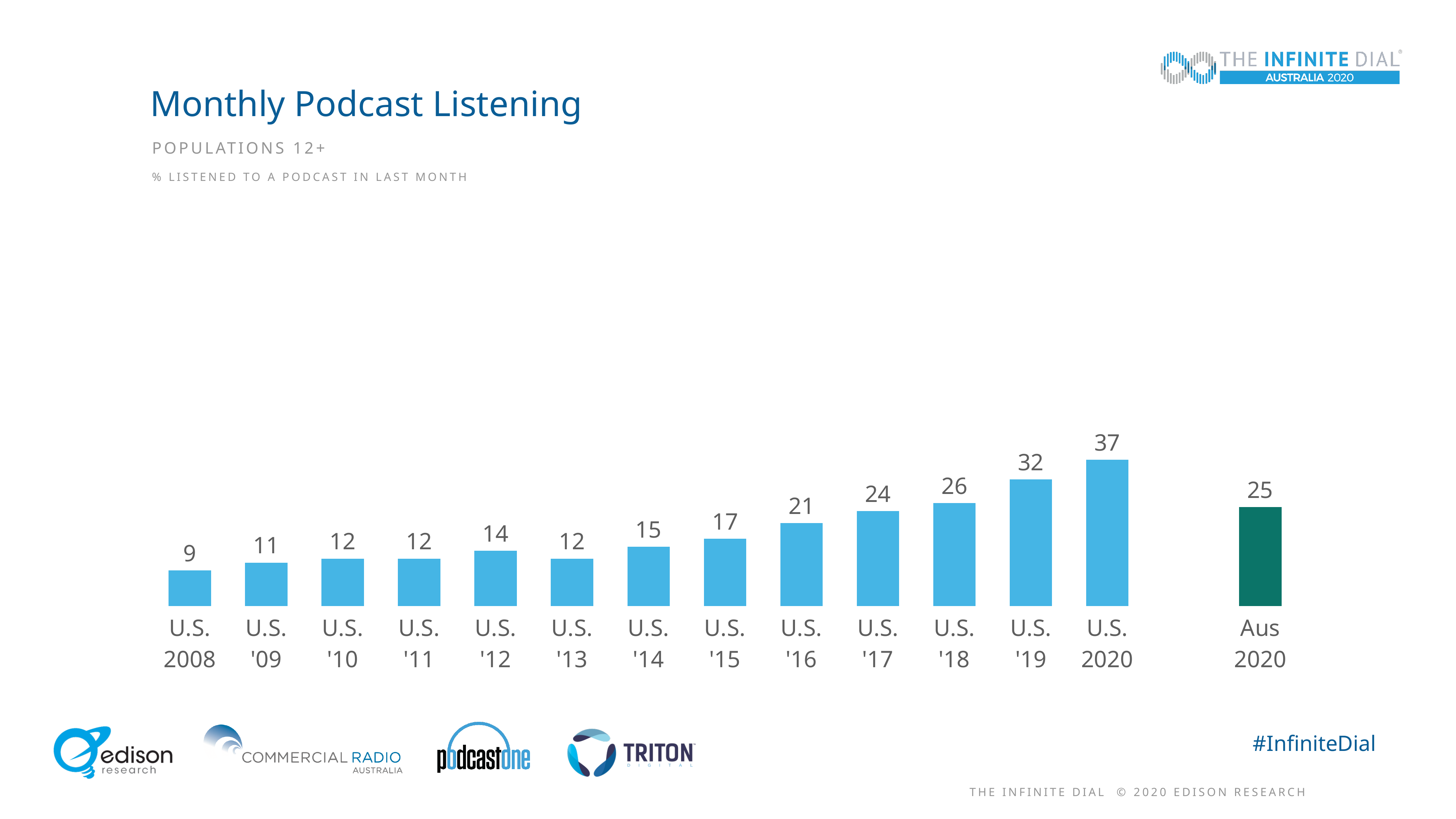
How many bars are shown in the chart? 14 What is the value for U.S. '16? 21 What is the value for U.S. 2008? 9 Which bar is shown in a different (dark green) colour from the others? Aus 2020 What is the difference between the values for U.S. 2020 and Aus 2020? 12 Which is larger, the value for U.S. '19 or the value for Aus 2020? U.S. '19 What kind of chart is shown on the slide? Bar chart Do the U.S. values generally rise or fall from 2008 to 2020? Rise Which category has the highest value? U.S. 2020 Which category has the lowest value? U.S. 2008 What is the title of the chart? Monthly Podcast Listening What is the value for Aus 2020? 25